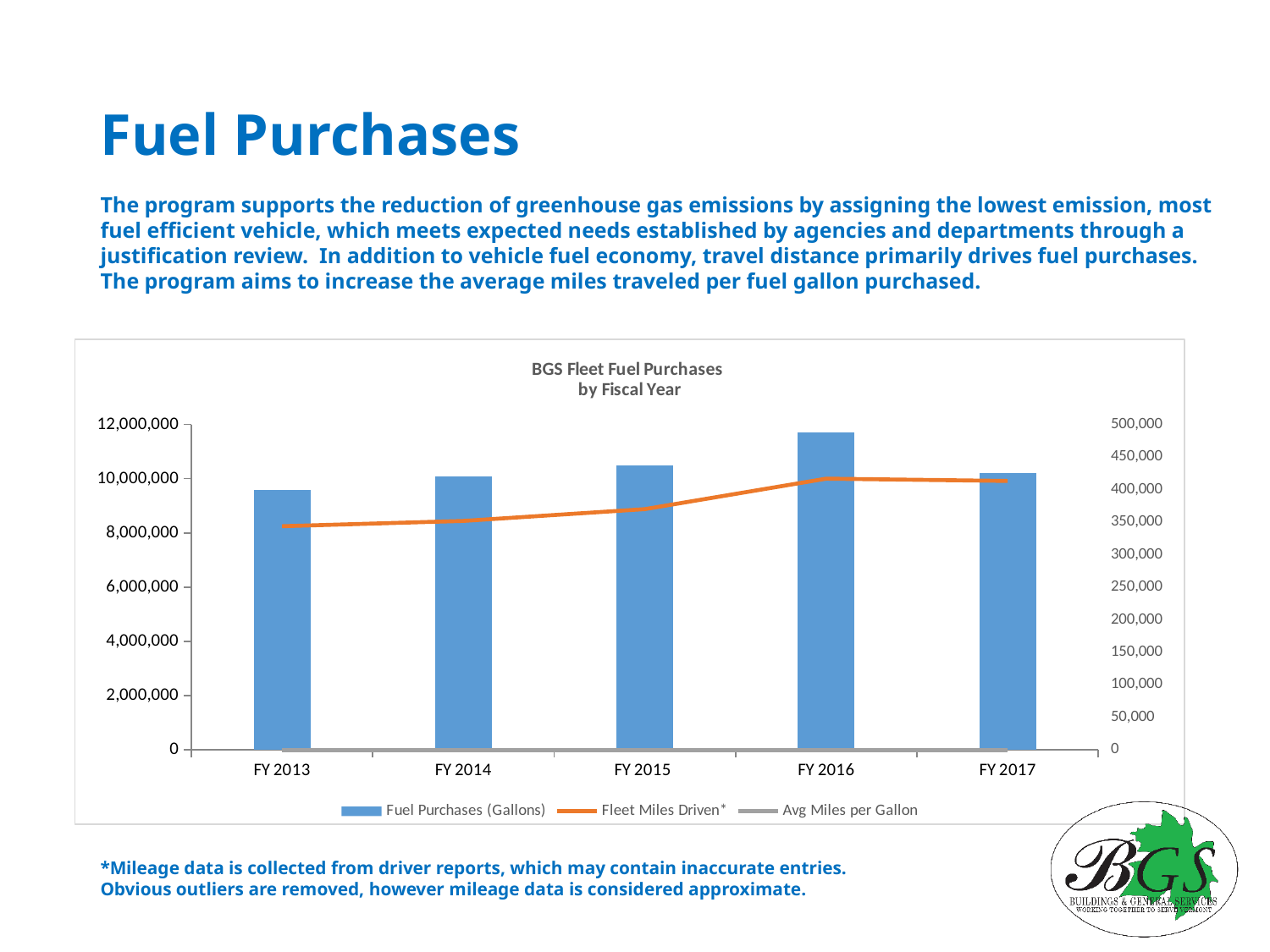
What kind of chart is used to show Fuel Purchases (Gallons)? Bar chart What is the title of the chart? BGS Fleet Fuel Purchases by Fiscal Year Which fiscal year has the lowest Fuel Purchases (Gallons) bar? FY 2013 Which fiscal year has the highest Fuel Purchases (Gallons) bar? FY 2016 How many fiscal years are shown on the x axis of the chart? 5 Does the Fleet Miles Driven line rise or fall from FY 2013 to FY 2016? rise Is the Fuel Purchases (Gallons) value for FY 2013 greater or less than 10,000,000? less How many series does the chart legend list? 3 Which series in the legend is drawn as an orange line? Fleet Miles Driven* Which fiscal year has higher Fuel Purchases (Gallons), FY 2013 or FY 2016? FY 2016